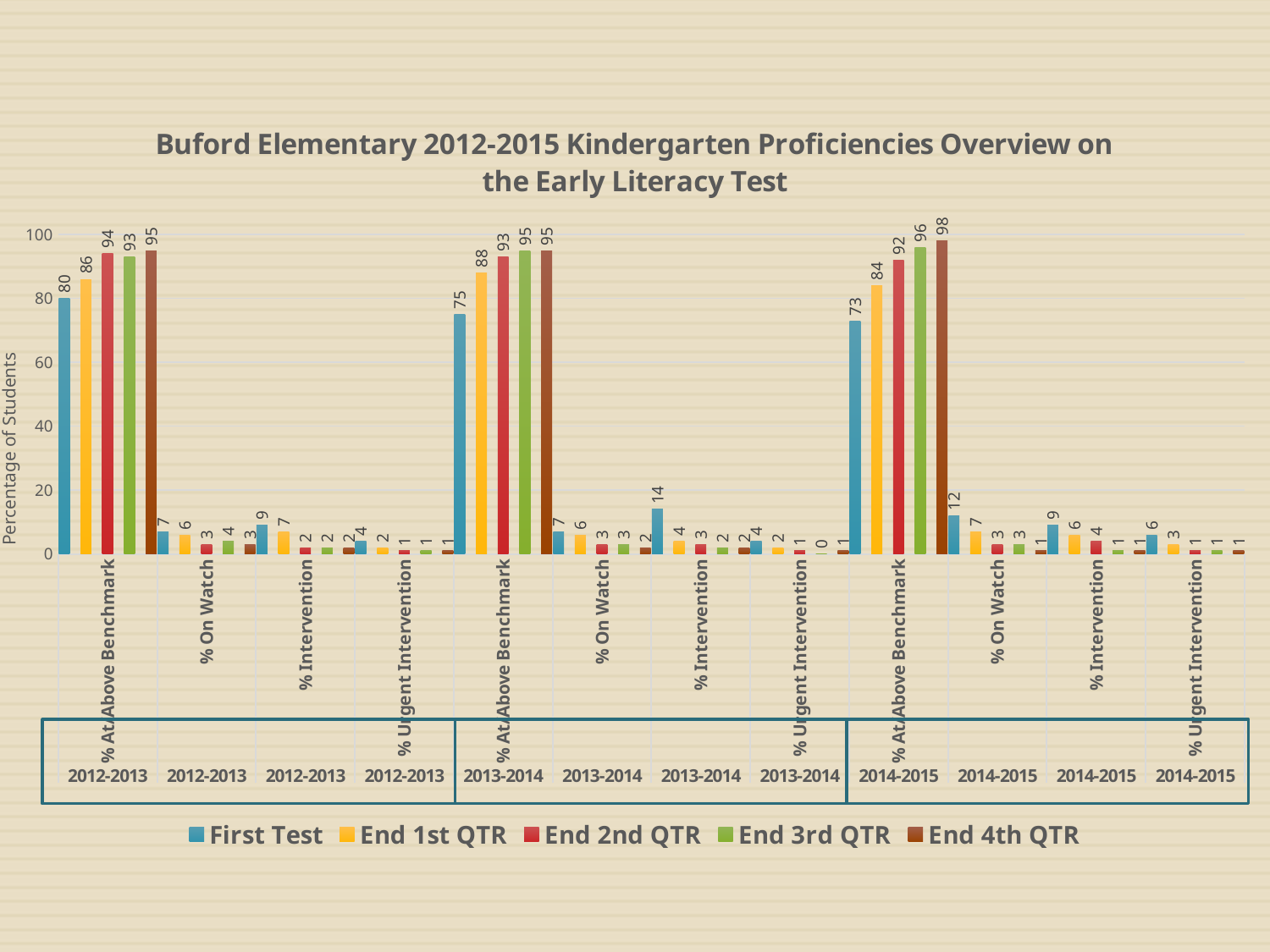
What is the End 1st QTR value for % At/Above Benchmark in 2013-2014? 88 Is the End 2nd QTR value for % At/Above Benchmark in 2012-2013 greater or less than 80? greater Do the % At/Above Benchmark values in 2014-2015 rise or fall from First Test to End 4th QTR? Rise Which series has the highest value for % At/Above Benchmark in 2014-2015? End 4th QTR How many series does the legend list? 5 What is the First Test value for % Intervention in 2013-2014? 14 Which series has the lowest value for % At/Above Benchmark in 2013-2014? First Test Which is larger: the First Test value for % On Watch in 2014-2015 or the First Test value for % On Watch in 2012-2013? 2014-2015 What is the difference between the End 4th QTR and First Test values for % At/Above Benchmark in 2014-2015? 25 What is the First Test value for % At/Above Benchmark in 2012-2013? 80 What kind of chart is shown on the slide? Bar chart What is the End 4th QTR value for % At/Above Benchmark in 2014-2015? 98